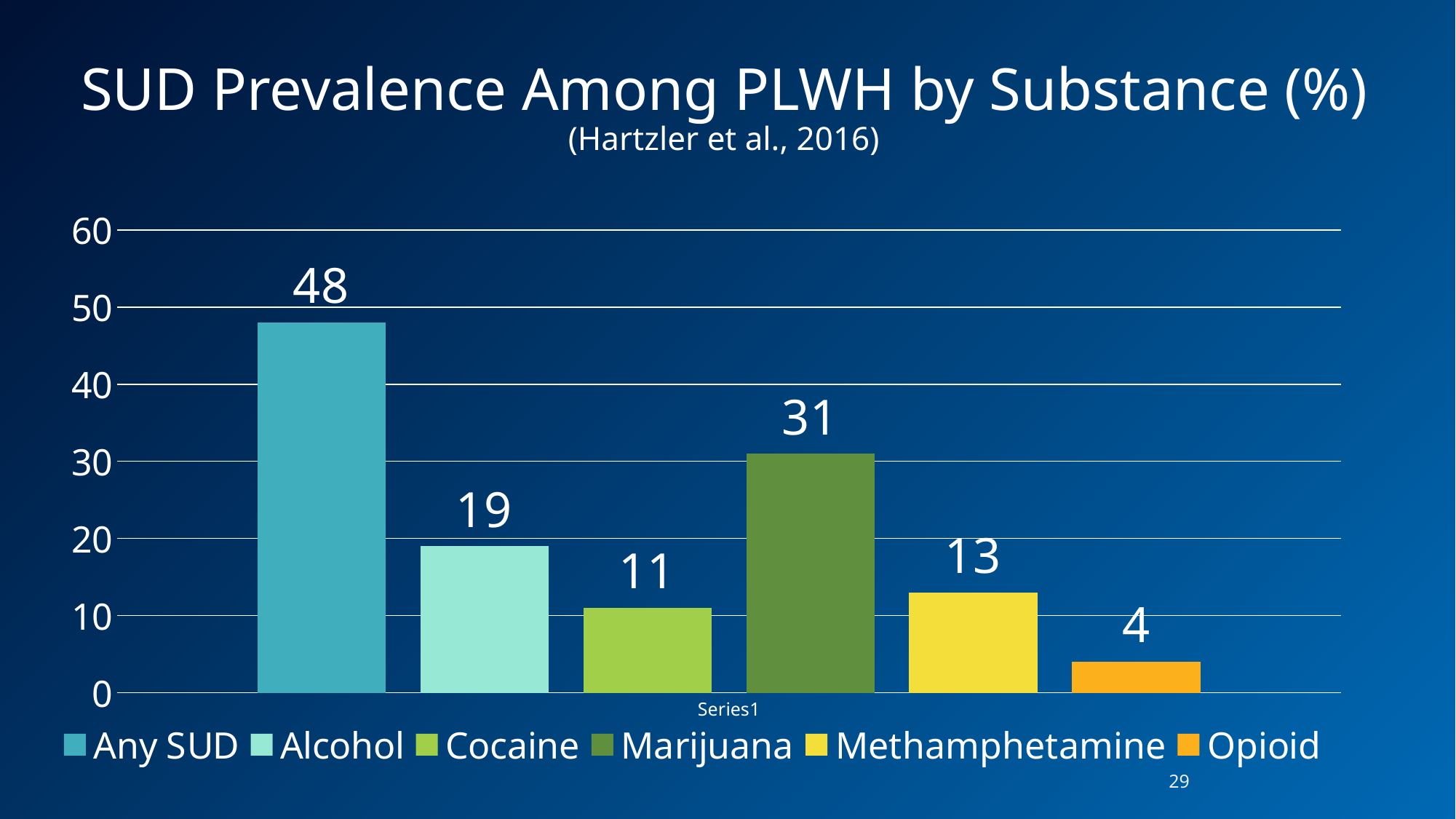
What kind of chart is shown on the slide? bar chart What is the value for Opioid? 4 Which category has the lowest value? Opioid Which category has the highest value? Any SUD Is the value for Marijuana greater or less than 30? greater What is the difference between the values for Any SUD and Marijuana? 17 How many bars are shown in the chart? 6 What is the title of the chart? SUD Prevalence Among PLWH by Substance (%) How many entries does the legend list? 6 What is the value for Marijuana? 31 Which is larger, the value for Cocaine or the value for Methamphetamine? Methamphetamine What is the value for Alcohol? 19